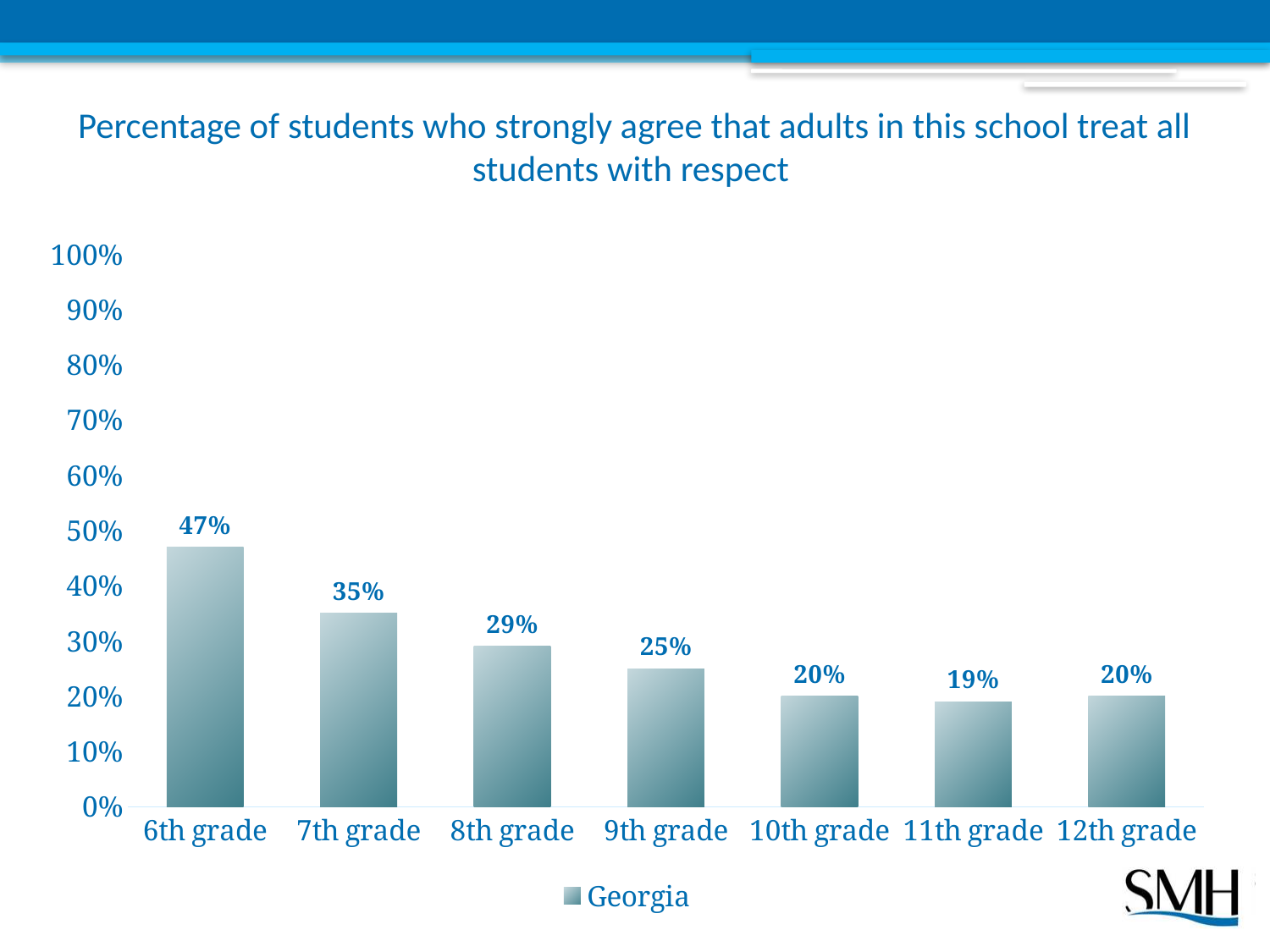
What kind of chart is shown on the slide? Bar chart How many grade categories are shown on the x axis? 7 What series name does the legend show? Georgia Which is larger, the value for 7th grade or the value for 8th grade? 7th grade What is the difference between the values for 8th grade and 12th grade? 9% What is the difference between the values for 6th grade and 7th grade? 12% What percentage of 6th grade students strongly agree that adults in this school treat all students with respect? 47% Which grade has the lowest percentage of students who strongly agree? 11th grade Is the value for 6th grade greater or less than 40%? greater What is the value shown for 9th grade? 25% What is the value shown for 11th grade? 19% Which grade has the highest percentage of students who strongly agree? 6th grade